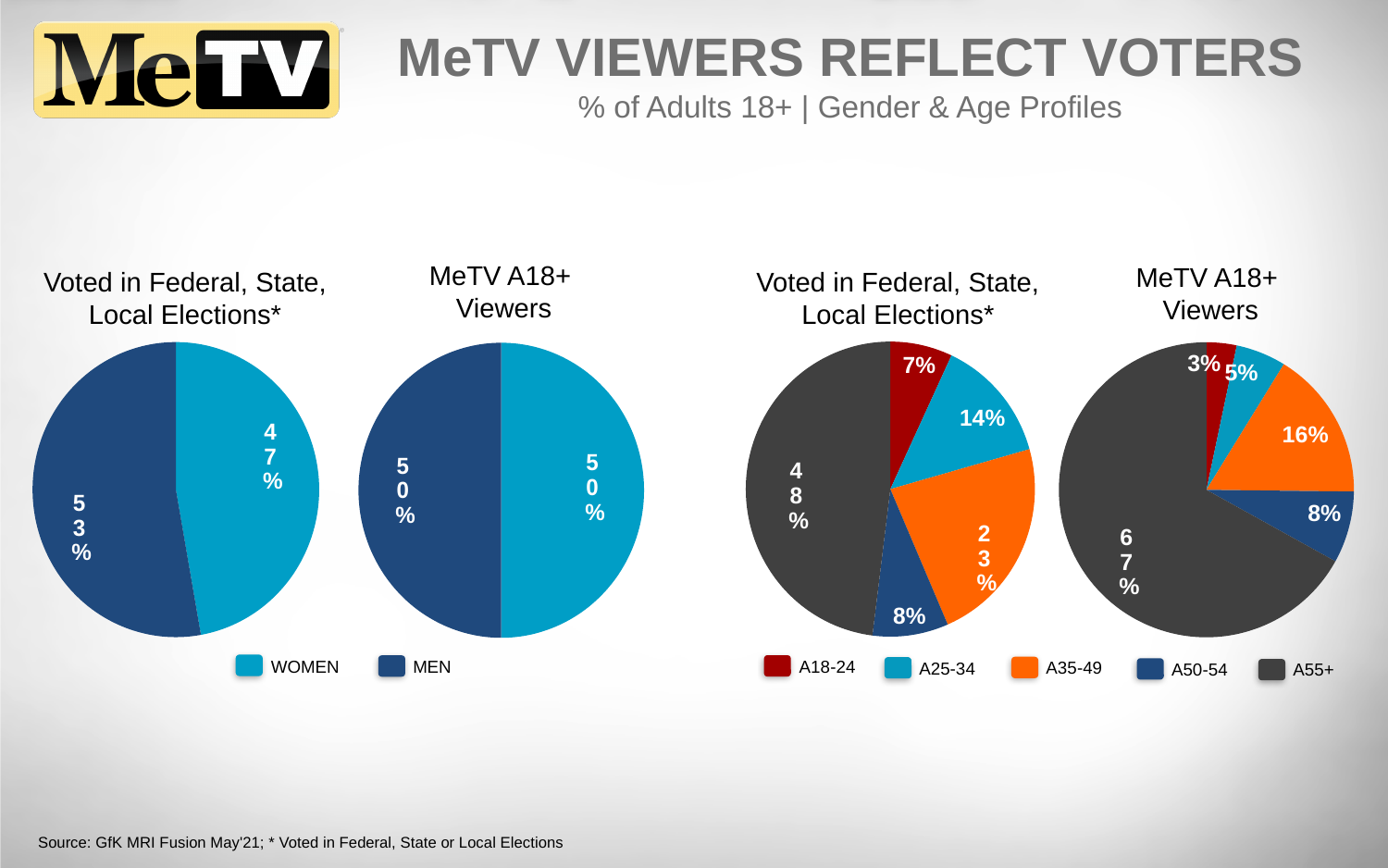
In the leftmost pie chart (Voted in Federal, State, Local Elections, gender), what percentage is WOMEN? 47% In the rightmost pie chart (MeTV A18+ Viewers, age), which age group has the smallest share? A18-24 In the rightmost pie chart (MeTV A18+ Viewers, age), what percentage is A55+? 67% In the third pie chart from the left (Voted in Federal, State, Local Elections, age), which age group has the largest share? A55+ In the leftmost pie chart (Voted in Federal, State, Local Elections, gender), what is the difference between the MEN and WOMEN shares? 6% What type of charts are shown on the slide? Pie charts In the third pie chart from the left (Voted in Federal, State, Local Elections, age), what percentage is A35-49? 23% In the second pie chart from the left (MeTV A18+ Viewers, gender), what percentage is WOMEN? 50% In the leftmost pie chart (Voted in Federal, State, Local Elections, gender), what percentage is MEN? 53% In the rightmost pie chart (MeTV A18+ Viewers, age), what is the difference between the A35-49 and A25-34 shares? 11% How many age groups does the legend for the age pie charts list? 5 In the leftmost pie chart (Voted in Federal, State, Local Elections, gender), which group has the larger share, WOMEN or MEN? MEN